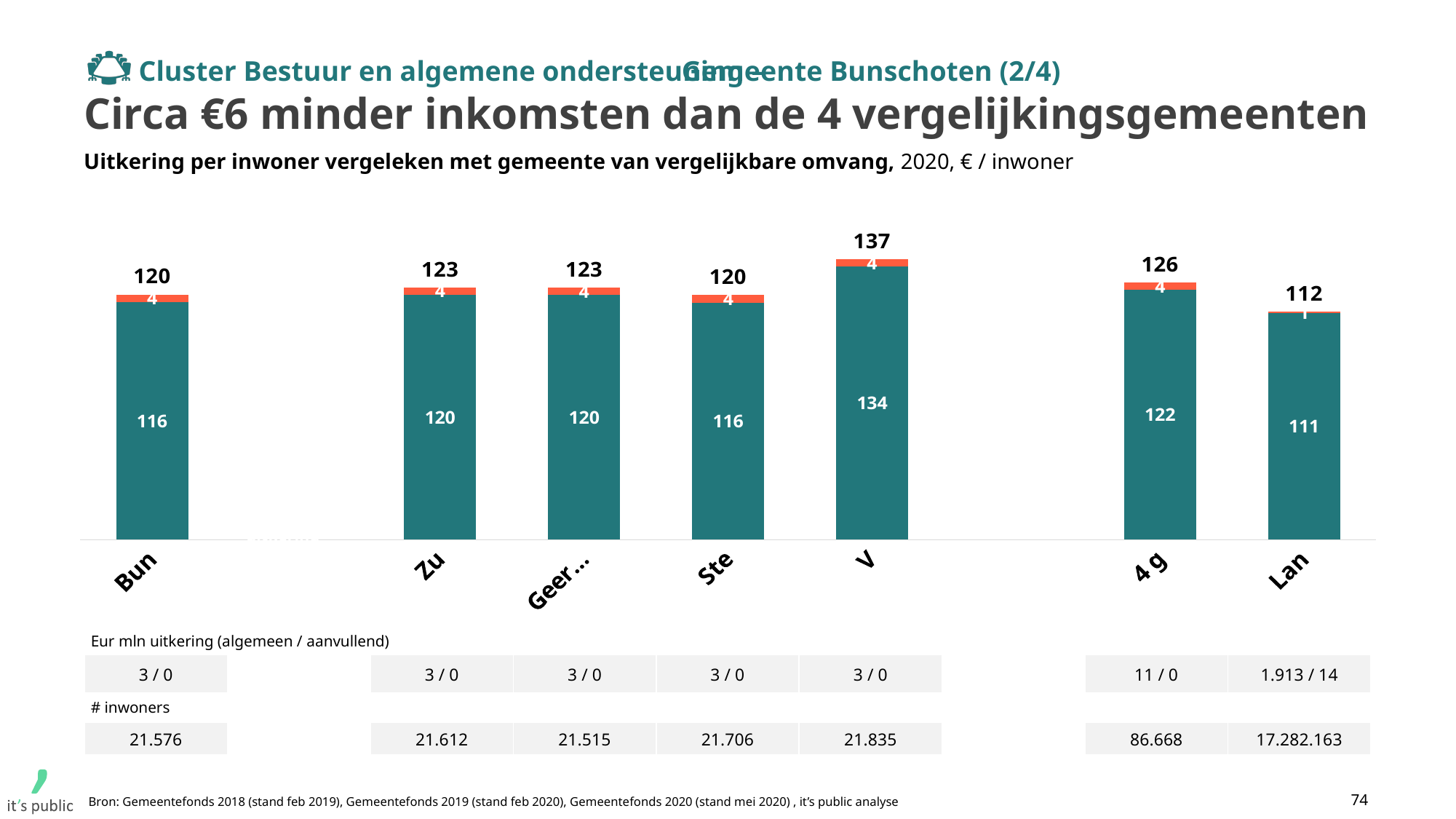
Which has a larger total, 4 g or Zu? 4 g What is the difference between the total for V and the total for Bun? 17 What is the total value shown above the bar for V? 137 What is the value of the teal (lower) segment for Bun? 116 What is the total of the stacked bar for Ste (116 + 4)? 120 Which category has the lowest total value? Lan What is the total value shown above the bar for Lan? 112 Which category has the highest total value? V How many bars are plotted in the chart? 7 What is the value of the teal (lower) segment for 4 g? 122 What is the unit stated in the chart subtitle? € / inwoner What kind of chart is shown on the slide? Stacked bar chart